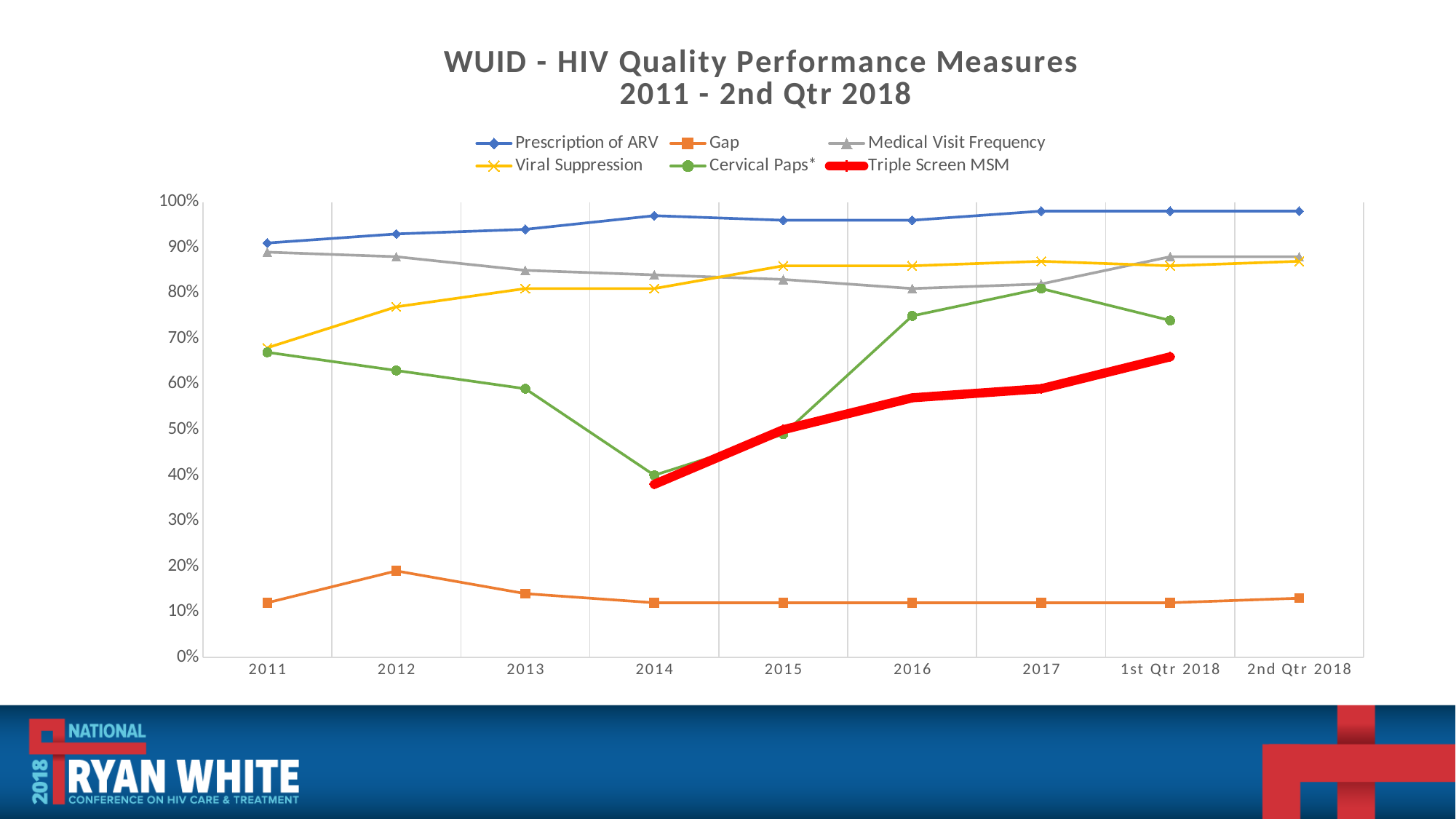
Does the Triple Screen MSM series rise or fall from 2014 to 1st Qtr 2018? rise Is the value for Triple Screen MSM in 1st Qtr 2018 greater or less than 60%? greater Is the value for Cervical Paps* in 2014 greater or less than 50%? less How many series does the legend list? 6 Is the value for Viral Suppression in 2011 greater or less than 80%? less What kind of chart is shown on the slide? line chart In which year does the Gap series reach its highest value? 2012 Which series has the highest value in 2011? Prescription of ARV Which series has the lowest values across the whole chart? Gap How many time points are shown along the x axis? 9 In which year does the Cervical Paps* series reach its lowest value? 2014 In 2014, which is larger: Viral Suppression or Cervical Paps*? Viral Suppression